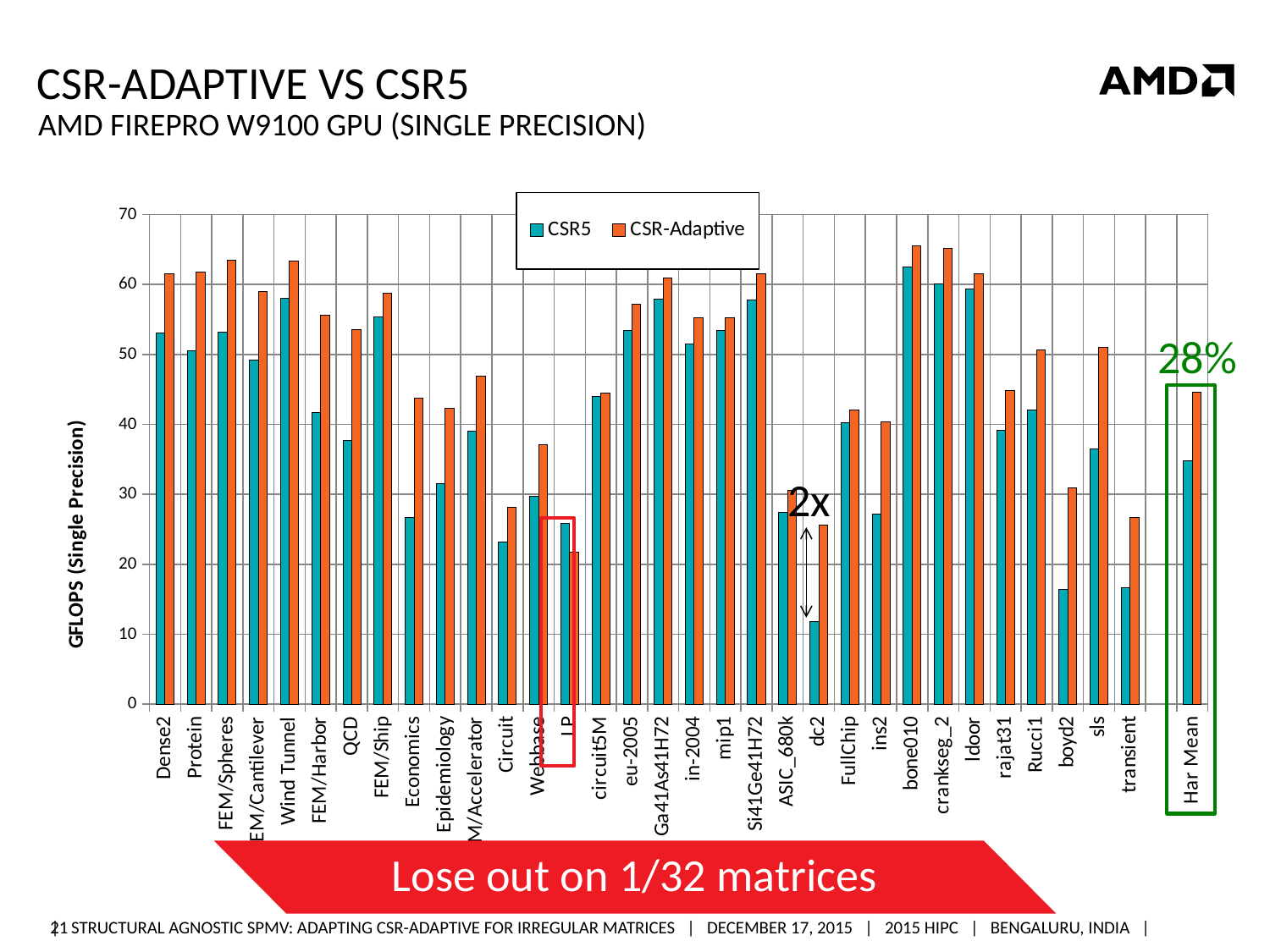
How many categories are shown along the x axis, including Har Mean? 33 Which two series are listed in the legend? CSR5 and CSR-Adaptive Which category has the lowest CSR-Adaptive value? LP Which category has the lowest CSR5 value? dc2 What is the label of the vertical axis? GFLOPS (Single Precision) What kind of chart is shown on the slide? bar chart How many series does the legend list? 2 Which category has the highest CSR5 value? bone010 For dc2, which series has the larger value, CSR5 or CSR-Adaptive? CSR-Adaptive For LP, which series has the larger value, CSR5 or CSR-Adaptive? CSR5 Is the CSR-Adaptive value for Dense2 greater or less than 60? greater Is the CSR5 value for Har Mean greater or less than 40? less